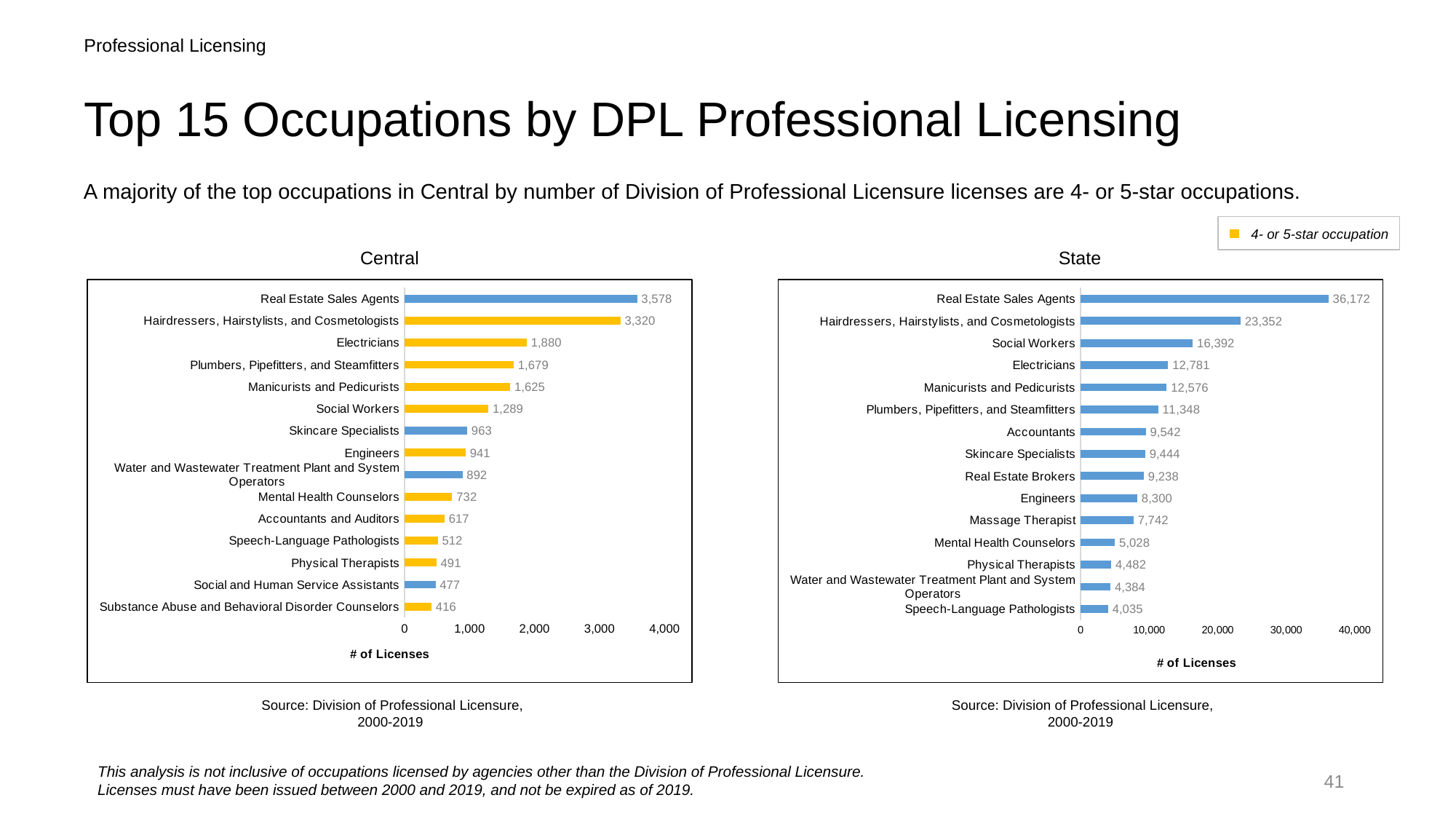
In the State chart, which has more licenses: Accountants or Massage Therapist? Accountants In the Central chart, what is the difference in licenses between Real Estate Sales Agents and Hairdressers, Hairstylists, and Cosmetologists? 258 In the Central chart, how many licenses are shown for Mental Health Counselors? 732 In the Central chart, which occupation has the fewest licenses? Substance Abuse and Behavioral Disorder Counselors In the Central chart, which has more licenses: Skincare Specialists or Engineers? Skincare Specialists In the Central chart, how many licenses are shown for Real Estate Sales Agents? 3,578 In the State chart, which occupation has the most licenses? Real Estate Sales Agents What type of chart is the State chart? Bar chart In the State chart, what is the difference in licenses between Electricians and Manicurists and Pedicurists? 205 How many occupations are listed in the Central chart? 15 In the State chart, how many licenses are shown for Social Workers? 16,392 What does the yellow colour in the legend indicate? 4- or 5-star occupation